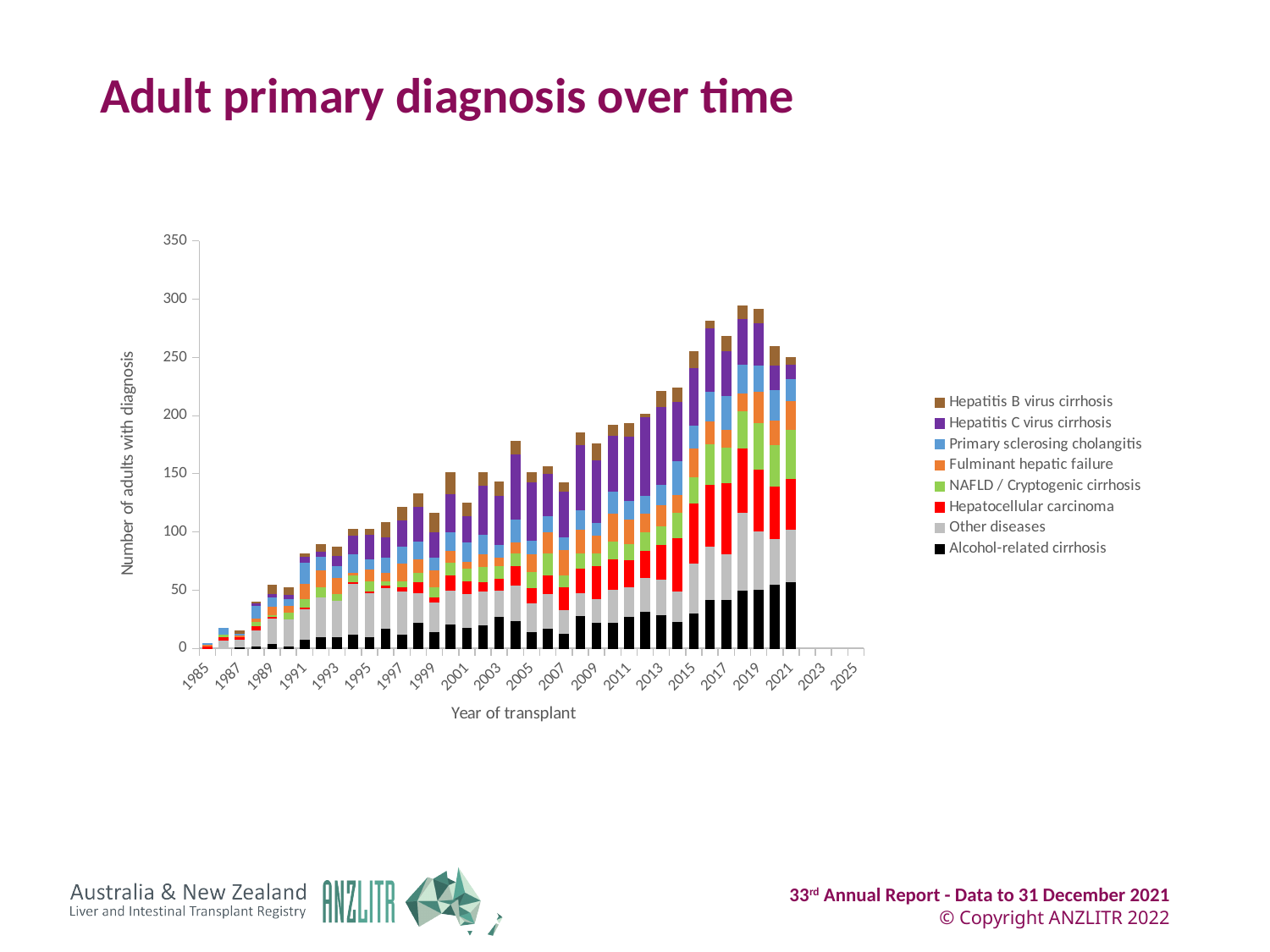
What is the title of the chart? Adult primary diagnosis over time Is the total for 1985 greater or less than 50? less What is the label of the vertical axis? Number of adults with diagnosis Is the total for 2000 greater or less than 100? greater Overall, do the total bar heights rise or fall from 1985 to 2018? rise Which of 2018 and 1995 has the larger total? 2018 Is the total for 2021 greater or less than 200? greater Which year has the lowest total number of adults with diagnosis? 1985 What kind of chart is shown on the slide? Stacked bar chart How many series does the legend list? 8